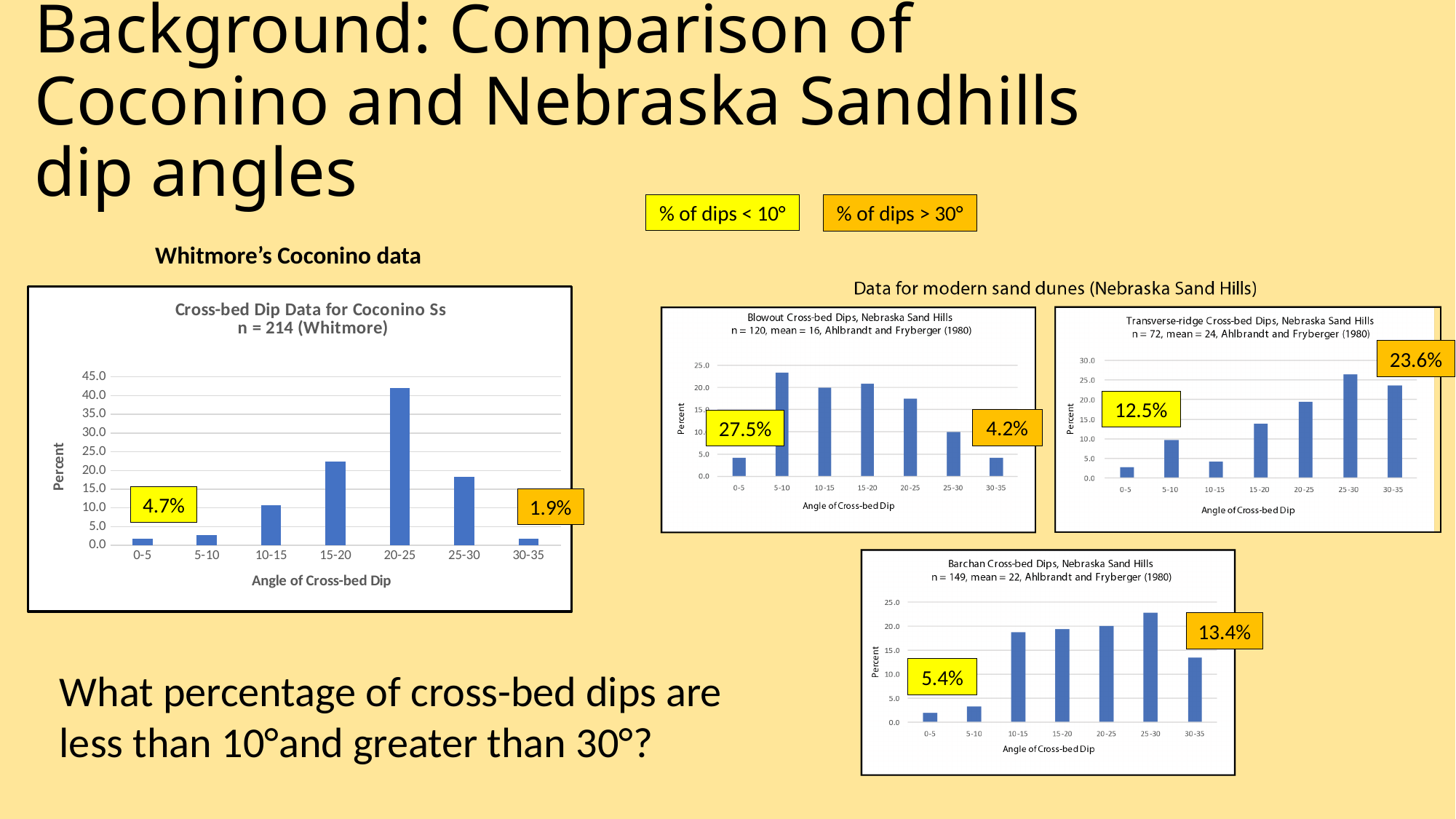
In the 'Cross-bed Dip Data for Coconino Ss' chart, which angle category has the highest percent? 20-25 What type of chart is the 'Cross-bed Dip Data for Coconino Ss' chart? bar chart In the 'Cross-bed Dip Data for Coconino Ss' chart, is the value for 20-25 greater or less than 40? greater According to the annotation on the 'Cross-bed Dip Data for Coconino Ss' chart, what percentage of dips are less than 10°? 4.7% In the 'Barchan Cross-bed Dips, Nebraska Sand Hills' chart, do the values rise or fall from 0-5 to 25-30? rise In the 'Transverse-ridge Cross-bed Dips, Nebraska Sand Hills' chart, which angle category has the lowest percent? 0-5 In the 'Transverse-ridge Cross-bed Dips, Nebraska Sand Hills' chart, which angle category has the highest percent? 25-30 In the 'Barchan Cross-bed Dips, Nebraska Sand Hills' chart, which is larger: the value for 25-30 or the value for 30-35? 25-30 In the 'Blowout Cross-bed Dips, Nebraska Sand Hills' chart, is the value for 5-10 greater or less than 20? greater In the 'Blowout Cross-bed Dips, Nebraska Sand Hills' chart, which angle category has the highest percent? 5-10 In the 'Barchan Cross-bed Dips, Nebraska Sand Hills' chart, is the value for 30-35 greater or less than 15? less How many angle categories are shown on the x axis of the 'Cross-bed Dip Data for Coconino Ss' chart? 7